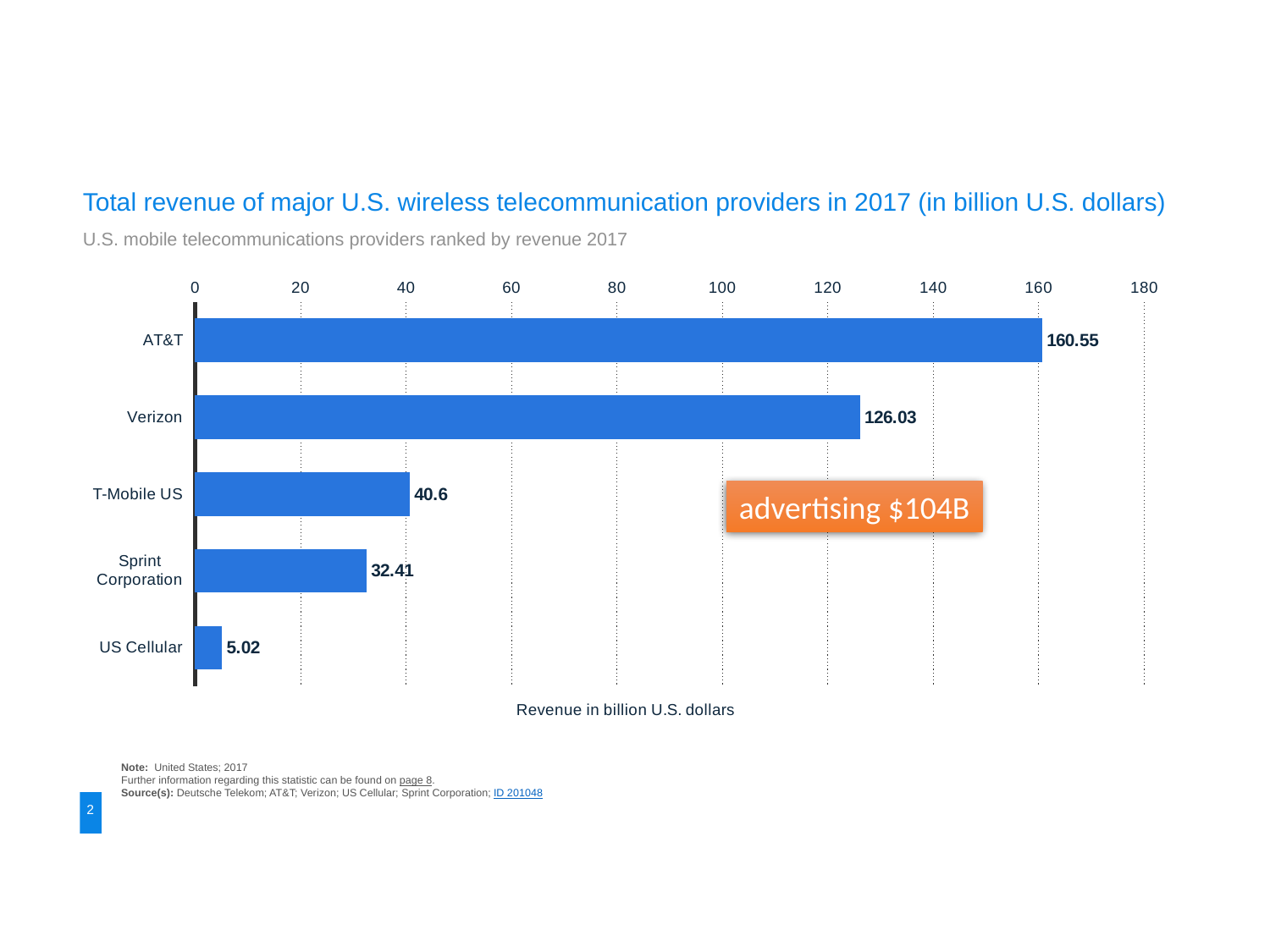
What is the label of the horizontal axis? Revenue in billion U.S. dollars Is the value for Verizon greater or less than 120? greater What is the revenue value shown for Verizon? 126.03 What is the difference between the revenue of AT&T and Verizon? 34.52 What kind of chart is shown on the slide? Bar chart How many providers are shown in the chart? 5 Which provider has the lowest revenue in the chart? US Cellular Which provider has the highest revenue in the chart? AT&T What is the revenue value shown for AT&T? 160.55 What is the revenue value shown for US Cellular? 5.02 What is the revenue value shown for T-Mobile US? 40.6 Which has a larger revenue, T-Mobile US or Sprint Corporation? T-Mobile US